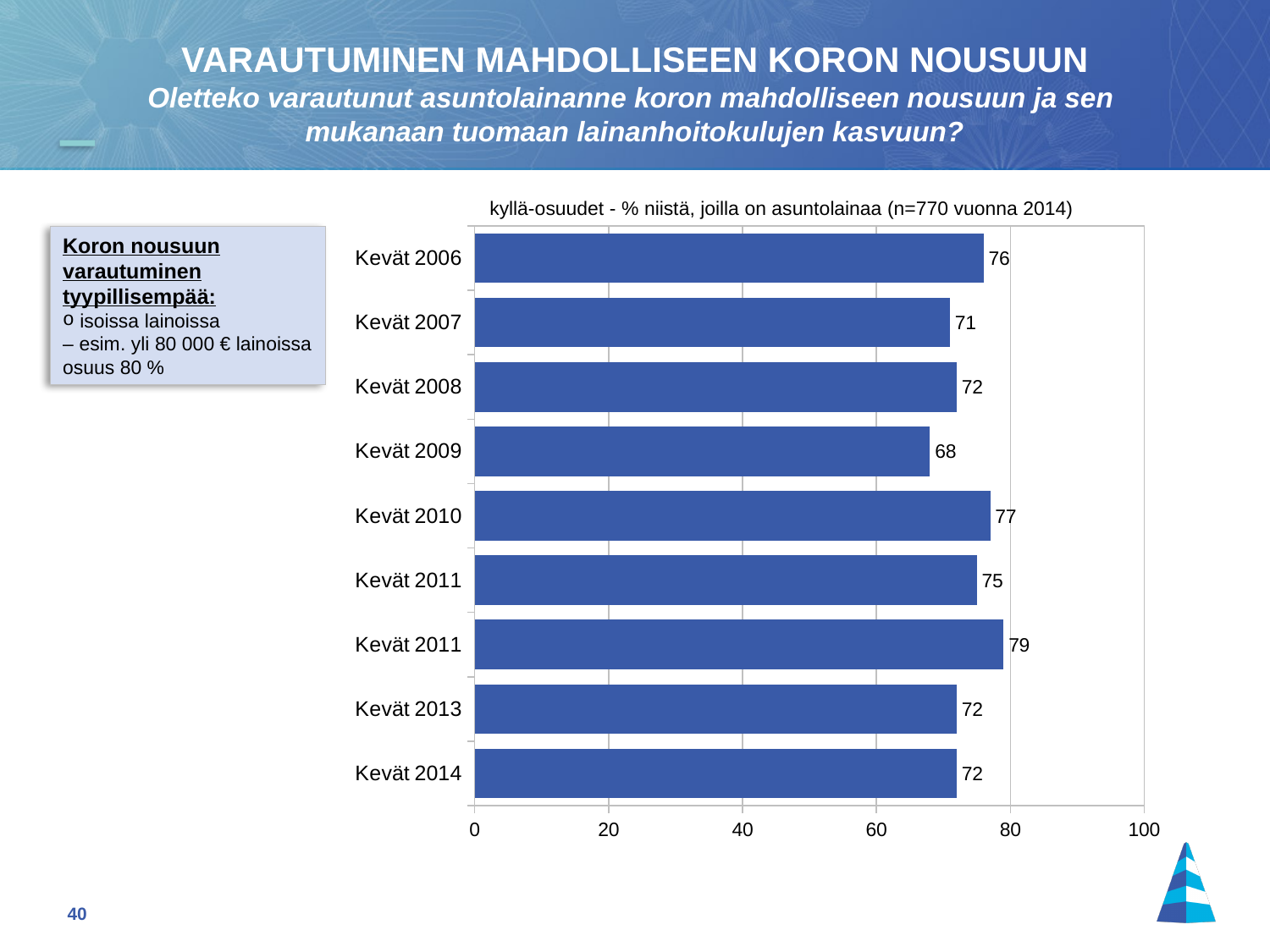
How many bars are shown in the chart? 9 What is the title of the chart? kyllä-osuudet - % niistä, joilla on asuntolainaa (n=770 vuonna 2014) Which is larger, the value for Kevät 2010 or the value for Kevät 2013? Kevät 2010 What is the difference between the values for Kevät 2010 and Kevät 2009? 9 Which category has the lowest value? Kevät 2009 What is the value for Kevät 2006? 76 What is the difference between the values for Kevät 2006 and Kevät 2007? 5 What is the highest value shown in the chart? 79 What is the value for Kevät 2014? 72 What is the value for Kevät 2007? 71 What is the value for Kevät 2009? 68 What kind of chart is shown on the slide? Bar chart